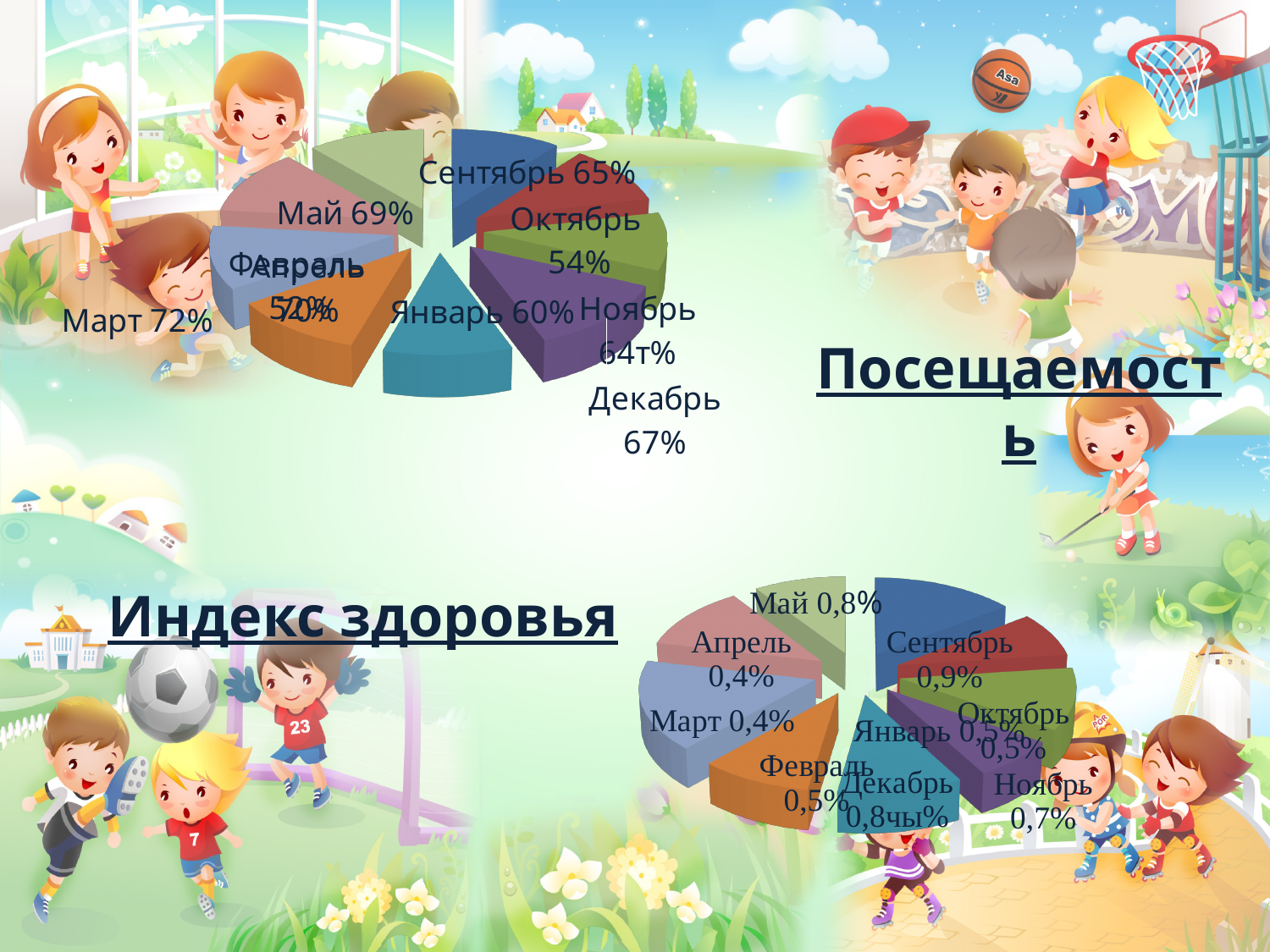
How many slices does the Индекс здоровья pie chart have? 9 On the Посещаемость chart, what is the value for Март? 72% On the Посещаемость chart, which is larger, Май or Январь? Май On the Посещаемость chart, what is the value for Октябрь? 54% On the Индекс здоровья chart, which is larger, Ноябрь or Октябрь? Ноябрь On the Посещаемость chart, what is the difference between Сентябрь and Октябрь? 11% What kind of chart is the Индекс здоровья chart? Pie chart On the Индекс здоровья chart, what is the value for Сентябрь? 0,9% On the Посещаемость chart, what is the value for Май? 69% On the Посещаемость chart, what is the value for Сентябрь? 65% On the Индекс здоровья chart, what is the value for Ноябрь? 0,7%